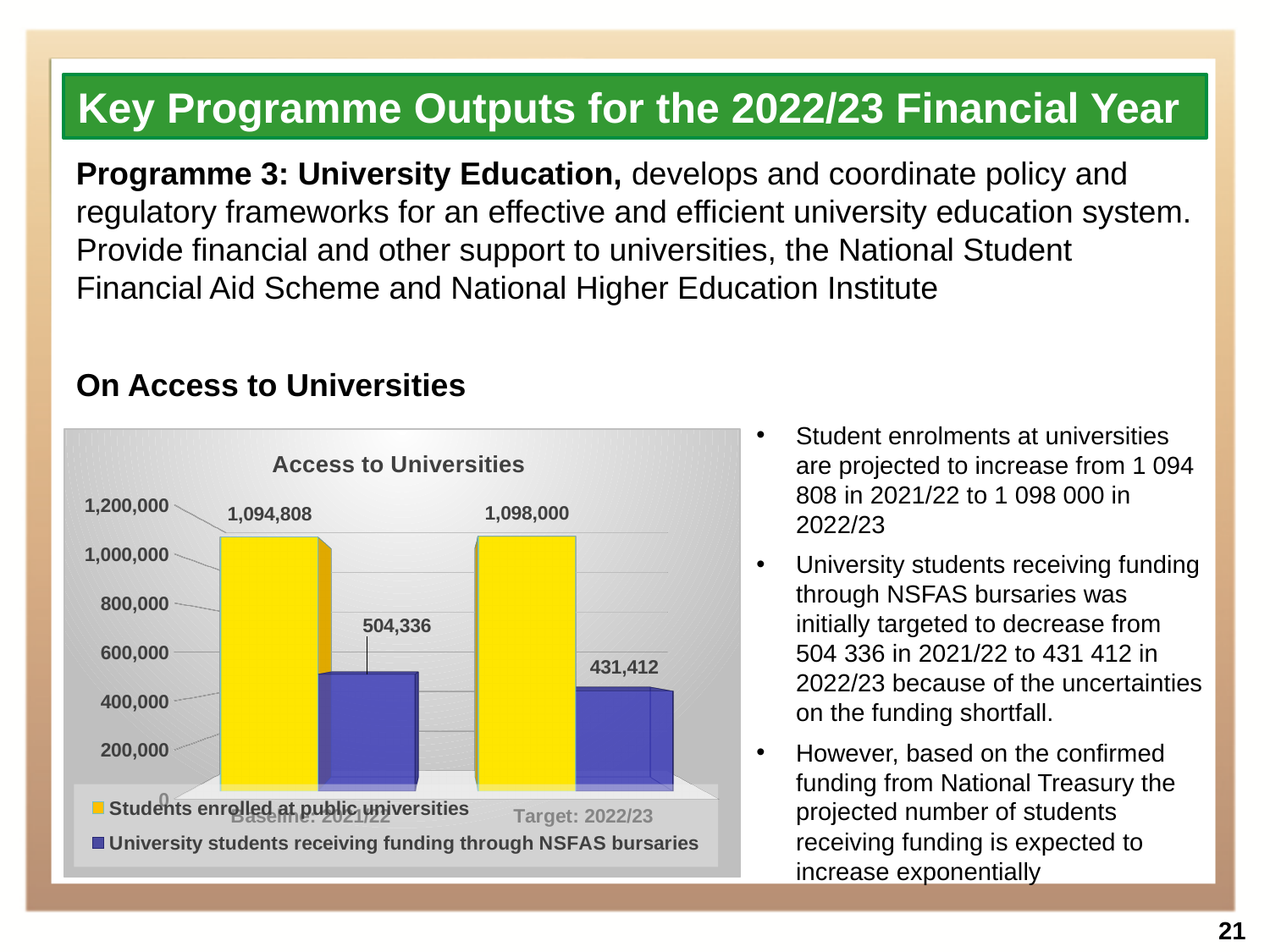
What is the value for University students receiving funding through NSFAS bursaries in Baseline: 2021/22? 504,336 How many categories are shown on the x axis? 2 What is the value for Students enrolled at public universities in Baseline: 2021/22? 1,094,808 How many series does the legend list? 2 What is the value for Students enrolled at public universities in Target: 2022/23? 1,098,000 What is the value for University students receiving funding through NSFAS bursaries in Target: 2022/23? 431,412 What type of chart is shown on the slide? bar chart Do the values for University students receiving funding through NSFAS bursaries rise or fall from Baseline: 2021/22 to Target: 2022/23? fall Which is larger in Target: 2022/23, Students enrolled at public universities or University students receiving funding through NSFAS bursaries? Students enrolled at public universities What is the title of the chart? Access to Universities What is the difference between the NSFAS bursary values for Baseline: 2021/22 and Target: 2022/23? 72,924 What is the difference between the Students enrolled at public universities values for Target: 2022/23 and Baseline: 2021/22? 3,192